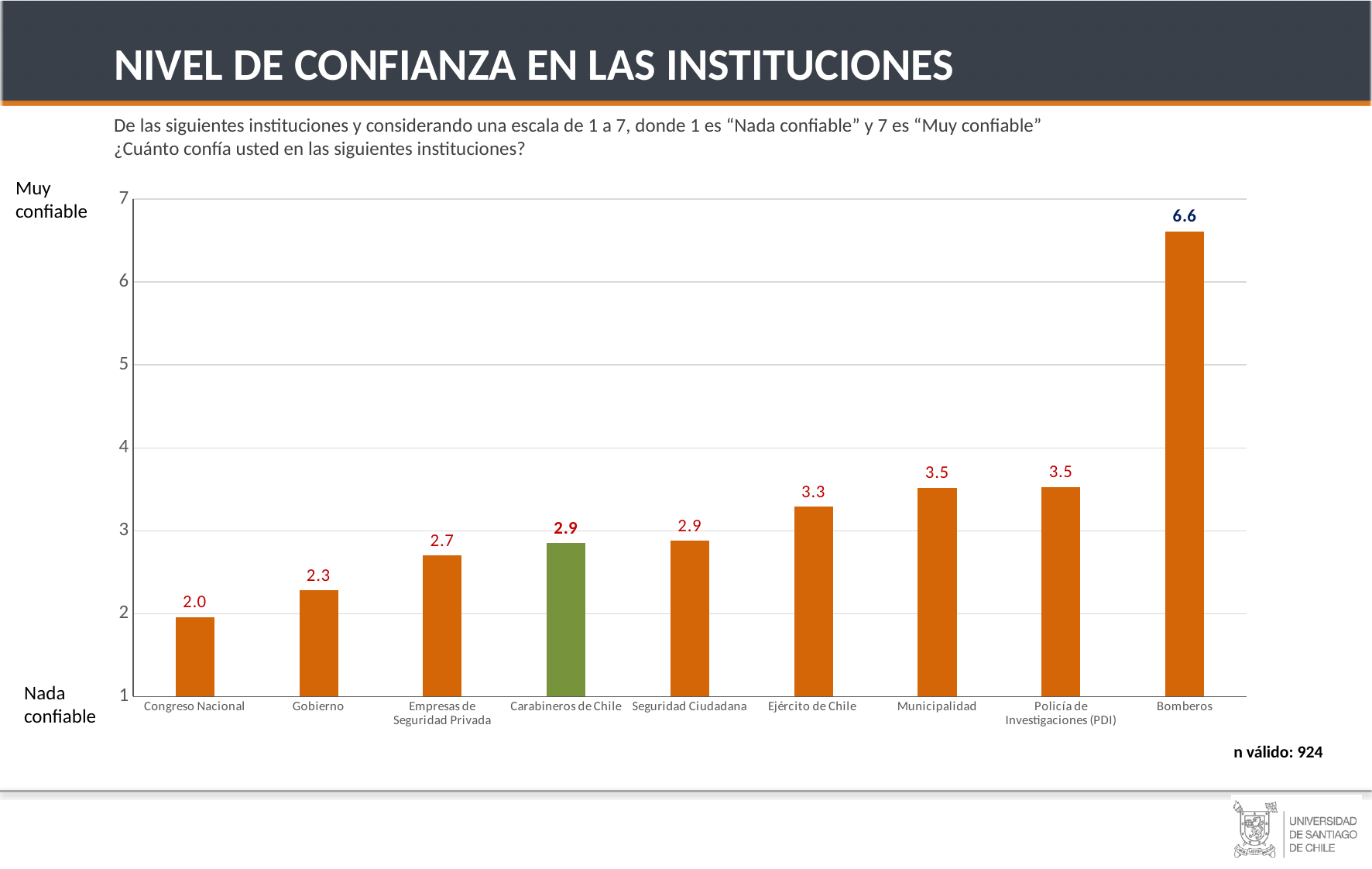
Which institution has the lowest value? Congreso Nacional What kind of chart is shown on the slide? Bar chart What is the difference between the values for Municipalidad and Gobierno? 1.2 Which is larger, the value for Gobierno or the value for Empresas de Seguridad Privada? Empresas de Seguridad Privada Which bar is coloured green instead of orange? Carabineros de Chile What is the value for Carabineros de Chile? 2.9 What is the value for Ejército de Chile? 3.3 What is the value for Bomberos? 6.6 How many institutions are shown on the chart? 9 What is the value for Congreso Nacional? 2.0 Which institution has the highest value? Bomberos What is the difference between the values for Bomberos and Congreso Nacional? 4.6